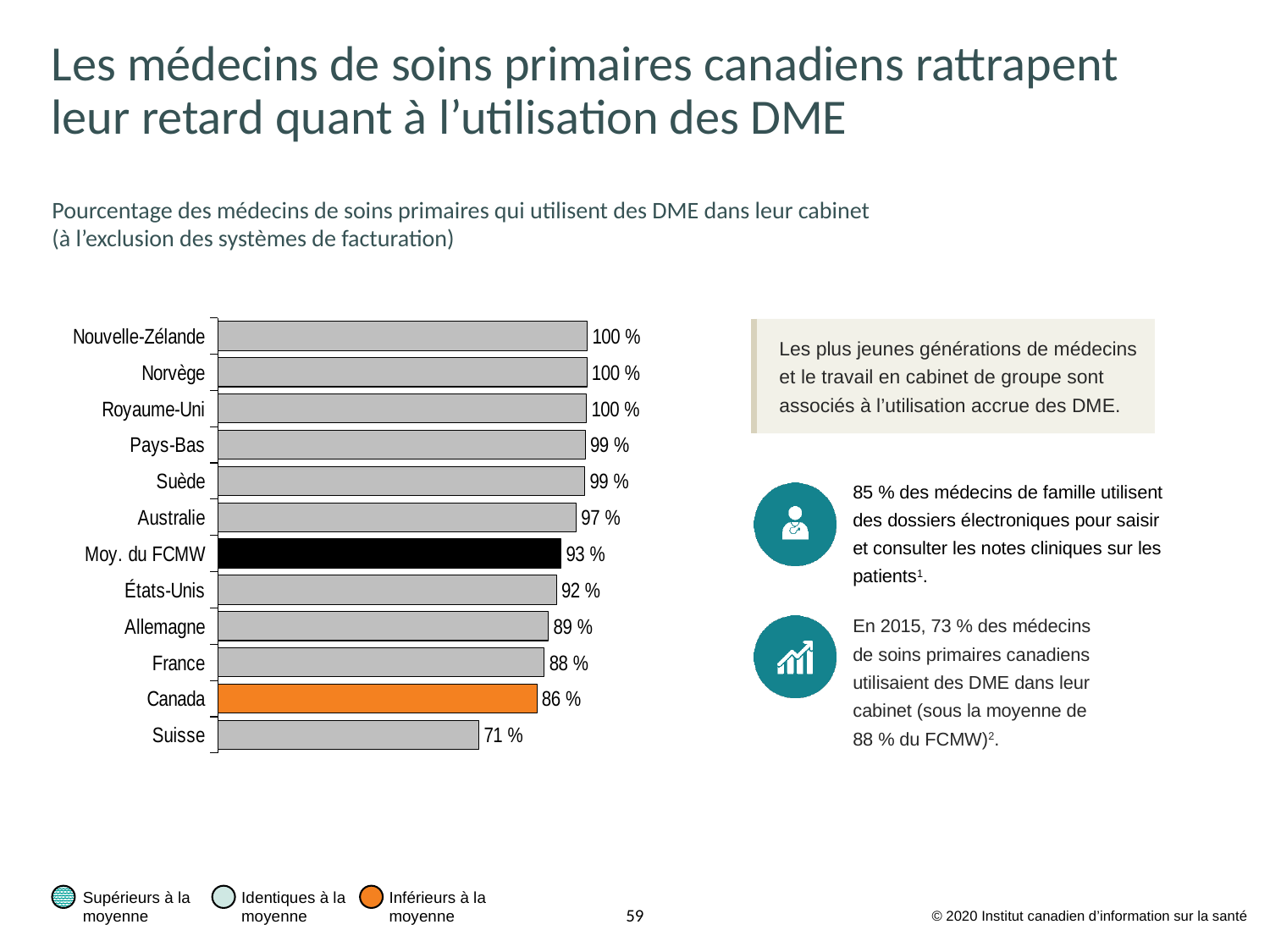
What is the difference between the values for Canada and Suisse? 15 % What is the value for Moy. du FCMW? 93 % What is the value for Australie? 97 % What colour is the bar for Canada? Orange Which category has the lowest value? Suisse Which is larger, the value for France or the value for Canada? France What is the value for Canada? 86 % What kind of chart is shown on the slide? Bar chart Which is larger, the value for Allemagne or the value for États-Unis? États-Unis How many categories are shown in the chart? 12 What is the value for Suisse? 71 % What is the difference between the values for Moy. du FCMW and Canada? 7 %